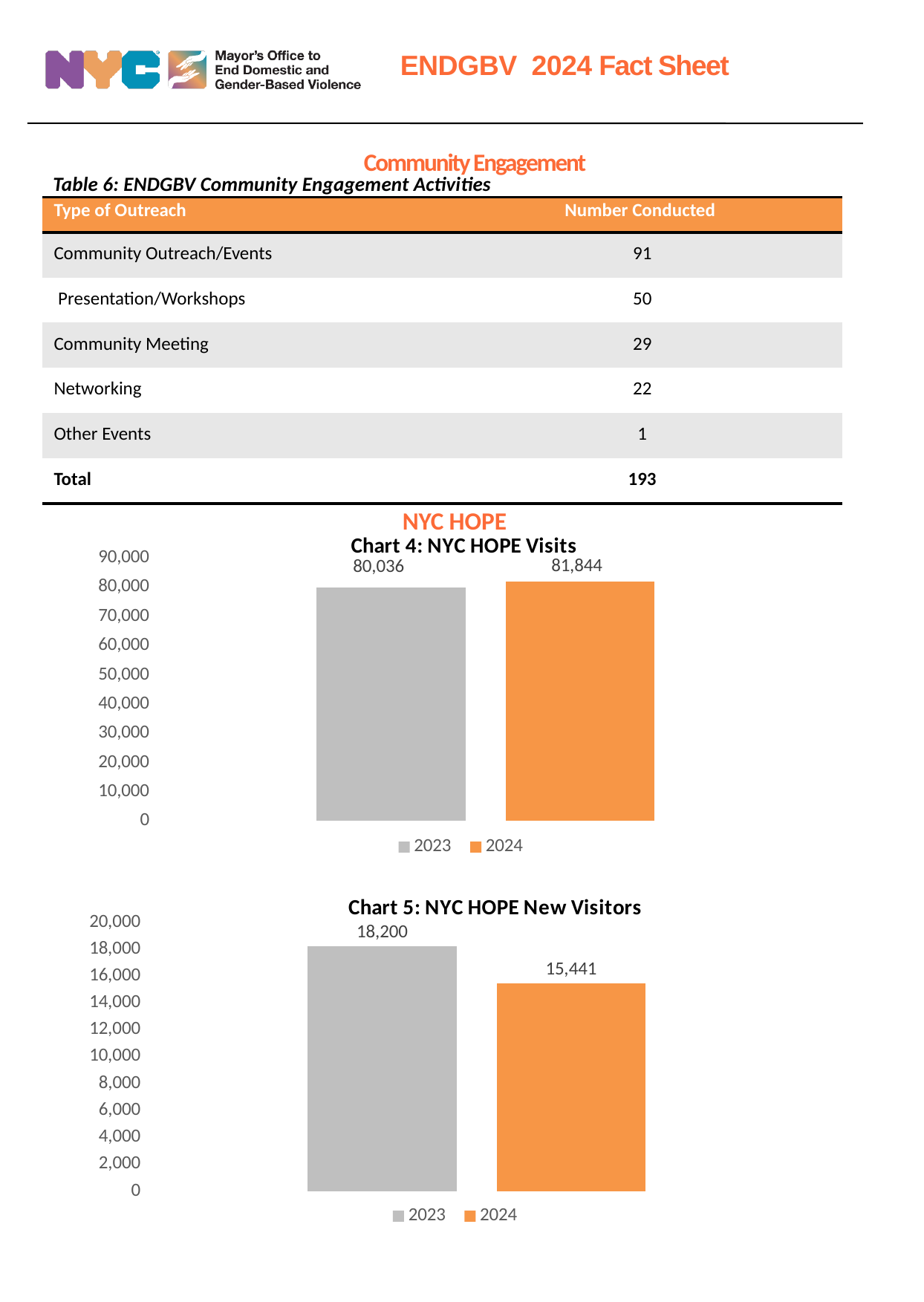
In Chart 4: NYC HOPE Visits, what is the difference between the 2024 and 2023 values? 1,808 In Chart 5: NYC HOPE New Visitors, what is the value for 2024? 15,441 In Chart 4: NYC HOPE Visits, what is the value for 2024? 81,844 In Chart 4: NYC HOPE Visits, how many series does the legend list? 2 In Chart 5: NYC HOPE New Visitors, which year has the higher value? 2023 In Chart 5: NYC HOPE New Visitors, is the value for 2024 greater or less than 16,000? less In Chart 5: NYC HOPE New Visitors, what is the difference between the 2023 and 2024 values? 2,759 In Chart 5: NYC HOPE New Visitors, what colour is the bar for 2024? Orange What kind of chart is Chart 4: NYC HOPE Visits? Bar chart In Chart 4: NYC HOPE Visits, what is the value for 2023? 80,036 In Chart 5: NYC HOPE New Visitors, what is the value for 2023? 18,200 In Chart 4: NYC HOPE Visits, is the value for 2023 greater or less than 70,000? greater